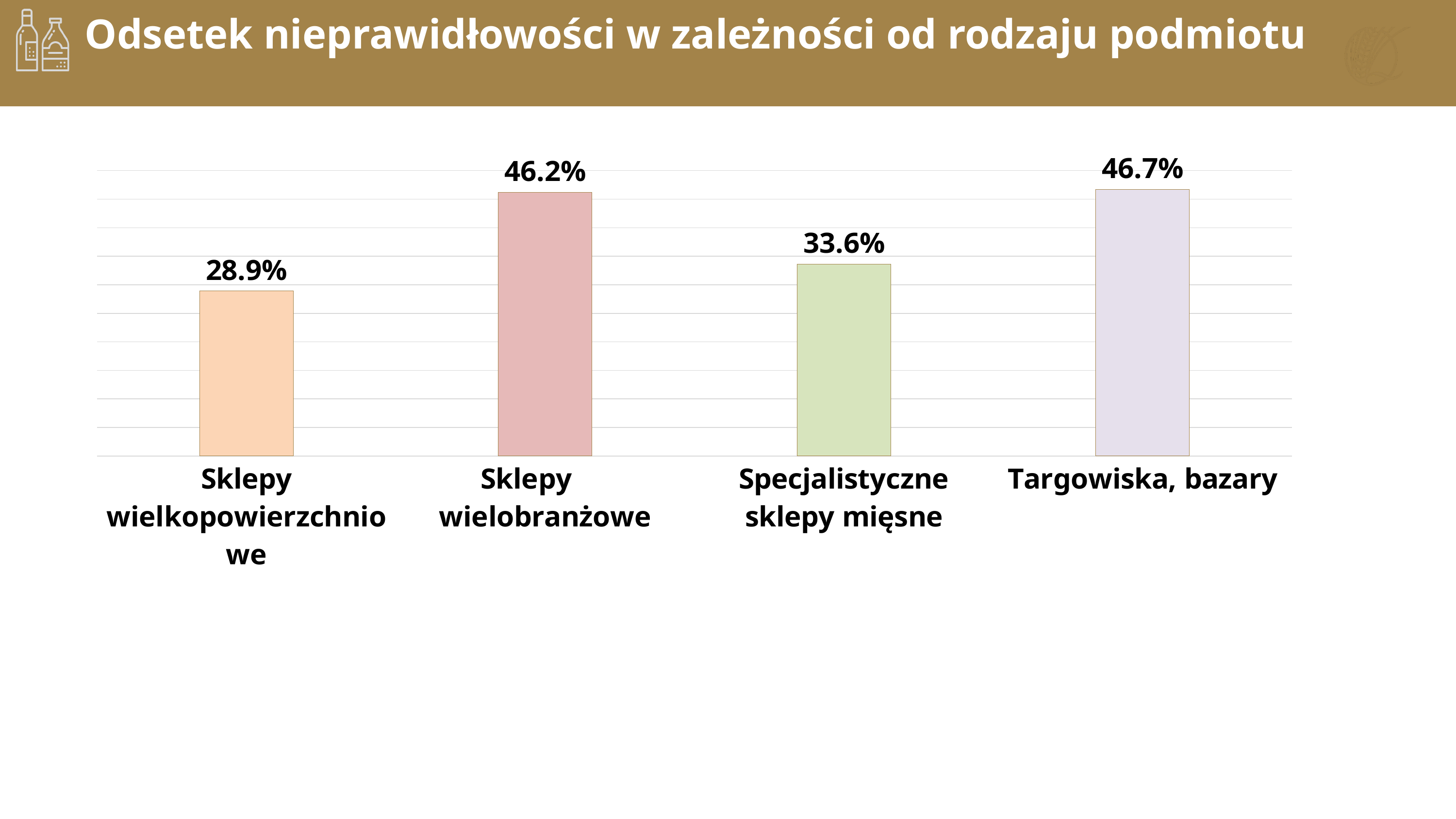
What is the value for Specjalistyczne sklepy mięsne? 33.6% What is the value for Targowiska, bazary? 46.7% What is the value for Sklepy wielkopowierzchniowe? 28.9% Which category has the highest value? Targowiska, bazary What kind of chart is shown on the slide? Bar chart What is the value for Sklepy wielobranżowe? 46.2% How many categories are shown in the chart? 4 What is the difference between the values for Sklepy wielobranżowe and Sklepy wielkopowierzchniowe? 17.3 percentage points What is the title of the slide? Odsetek nieprawidłowości w zależności od rodzaju podmiotu Which category has the lowest value? Sklepy wielkopowierzchniowe What is the difference between the values for Targowiska, bazary and Specjalistyczne sklepy mięsne? 13.1 percentage points Which is larger, the value for Specjalistyczne sklepy mięsne or the value for Sklepy wielkopowierzchniowe? Specjalistyczne sklepy mięsne